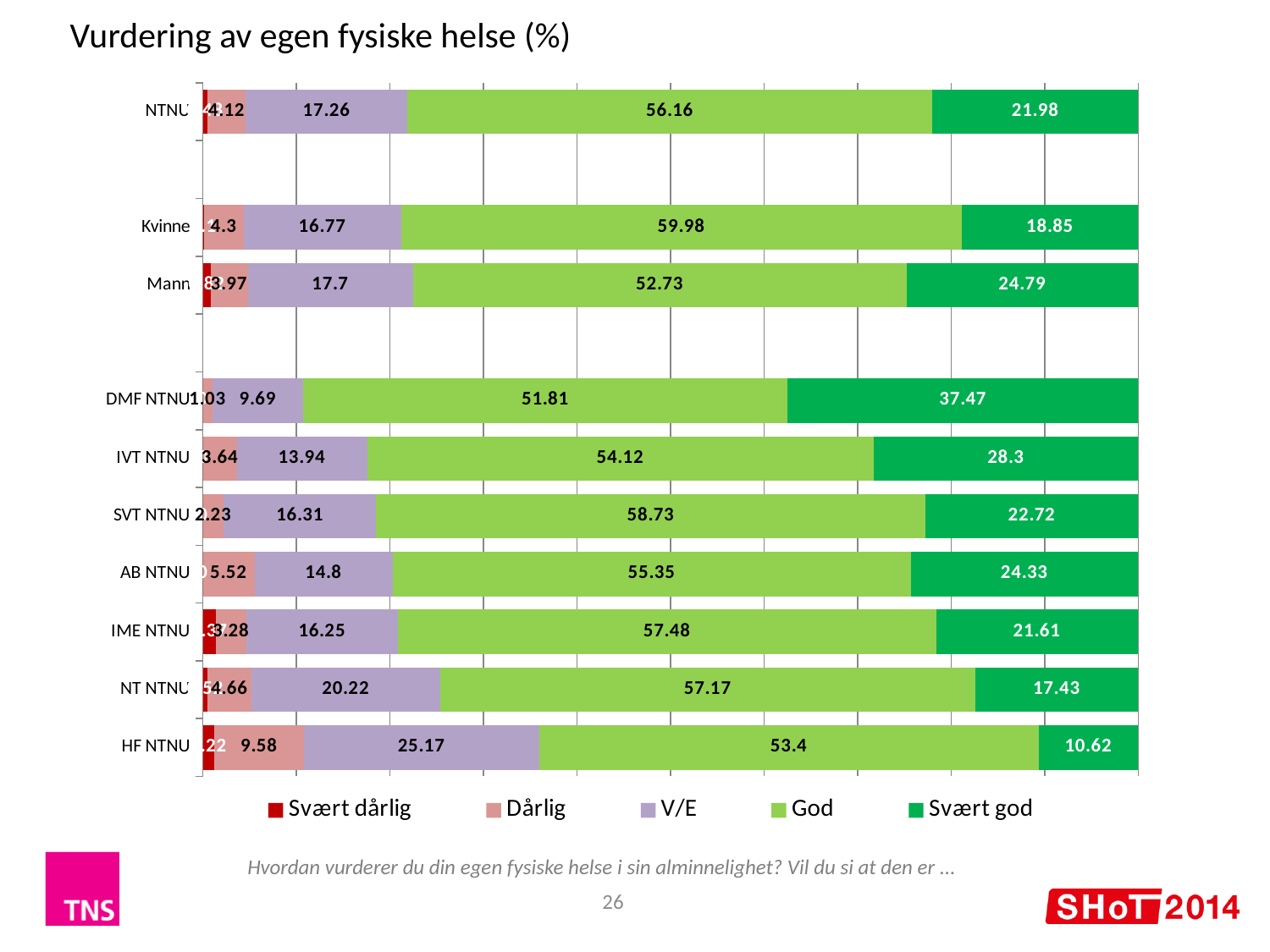
What is the difference between the 'Svært god' values for Mann and Kvinne? 5.94 What is the value of 'Svært god' for DMF NTNU? 37.47 What is the value of 'God' for Kvinne? 59.98 Which has a larger 'God' value, Kvinne or Mann? Kvinne Which category has the highest 'Svært god' value? DMF NTNU What is the value of 'V/E' for HF NTNU? 25.17 What type of chart is shown on the slide? Stacked bar chart What is the value of 'Dårlig' for AB NTNU? 5.52 Which category has the lowest 'V/E' value? DMF NTNU How many series does the legend list? 5 Which category has the lowest 'Svært god' value? HF NTNU How many categories are shown on the chart? 10